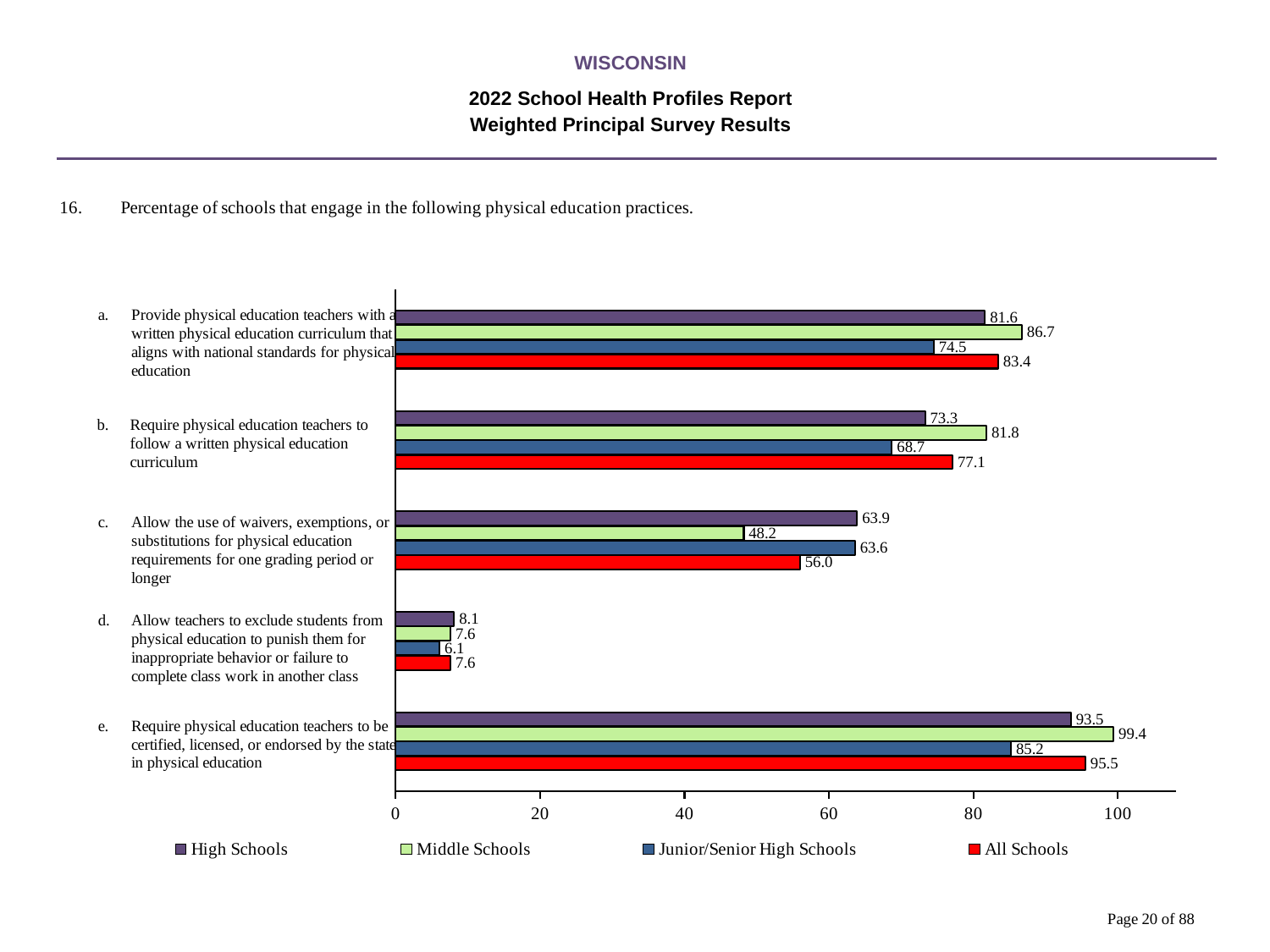
What is the value for All Schools for practice c, allowing waivers, exemptions, or substitutions for physical education requirements? 56.0 How many physical education practices are shown on the chart? 5 Which practice has the lowest value for High Schools? d. Allow teachers to exclude students from physical education to punish them What is the value for Junior/Senior High Schools for practice b, requiring physical education teachers to follow a written physical education curriculum? 68.7 What colour represents All Schools in the chart? Red What is the difference between the High Schools and All Schools values for practice e? 2.0 Which practice has the highest value for All Schools? e. Require physical education teachers to be certified, licensed, or endorsed by the state What is the value for Middle Schools for practice e, requiring physical education teachers to be certified, licensed, or endorsed by the state? 99.4 For practice c, which is larger: the High Schools value or the Middle Schools value? High Schools What is the difference between the Middle Schools and Junior/Senior High Schools values for practice a? 12.2 How many series does the legend list? 4 What kind of chart is shown on the slide? Bar chart